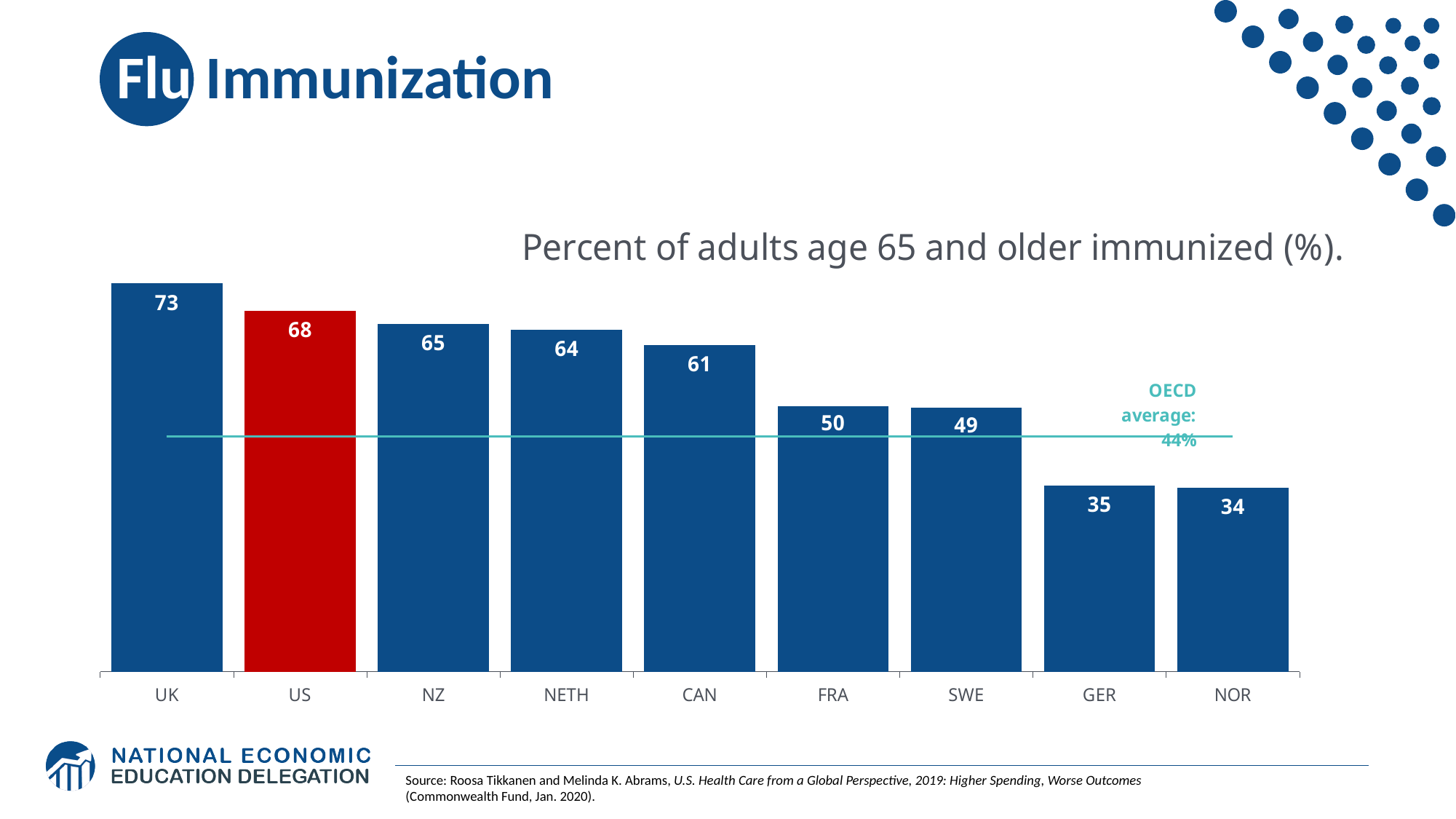
What is the value for the US? 68 Which country has the highest value? UK Which country has the lowest value? NOR Do the values rise or fall from left to right along the x axis? Fall What is the value for NETH? 64 Which is larger, the value for NZ or the value for SWE? NZ What OECD average value is marked by the horizontal line on the chart? 44% What is the difference between the values for the UK and the US? 5 What kind of chart is shown on the slide? Bar chart How many countries are shown on the chart? 9 What is the difference between the values for CAN and GER? 26 What is the value for FRA? 50